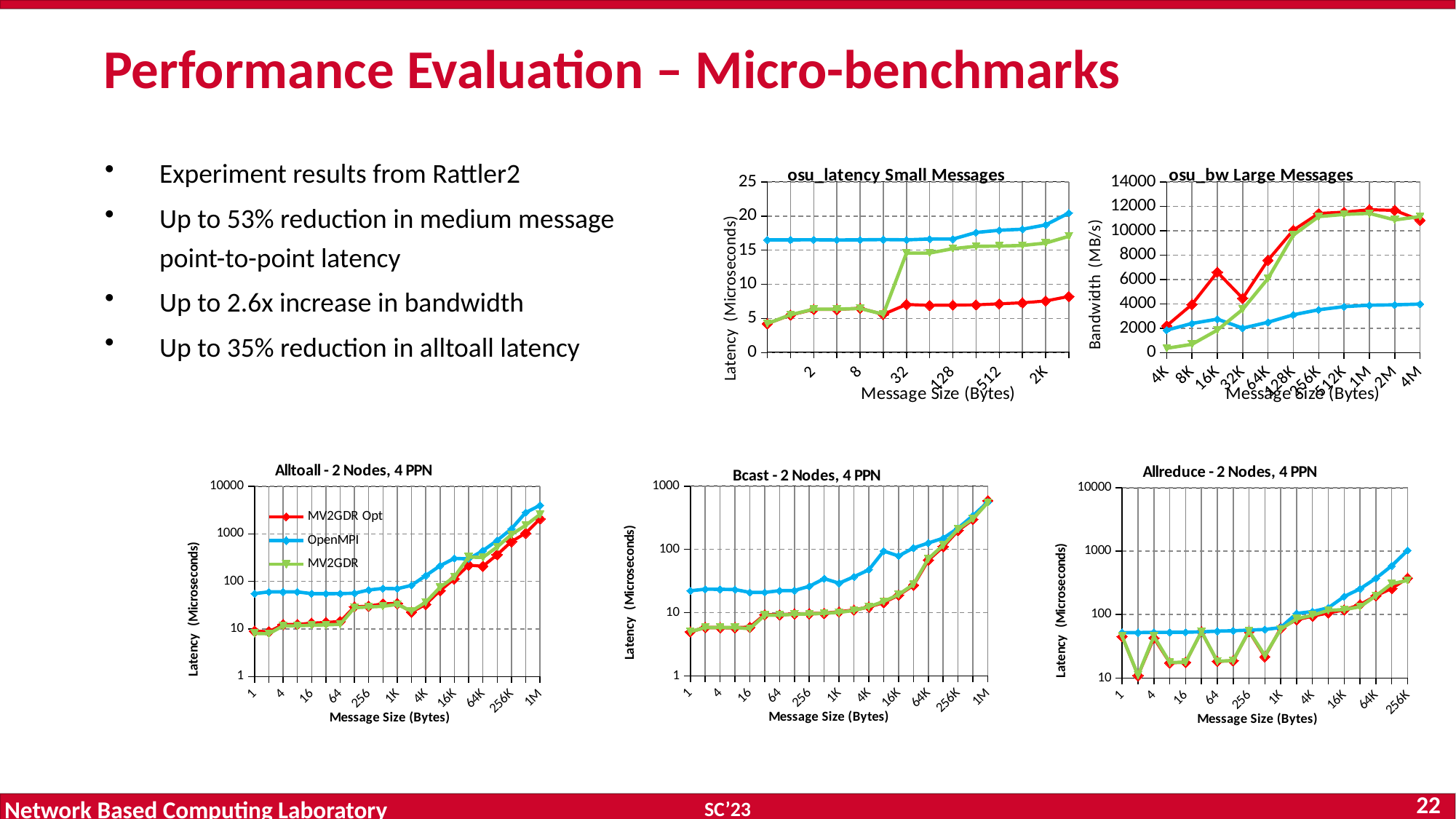
In the 'osu_bw Large Messages' chart, at message size 16K, which line has the higher value, the red line or the blue line? the red line How many message sizes are shown on the x axis of the 'osu_bw Large Messages' chart? 11 In the 'Bcast - 2 Nodes, 4 PPN' chart, at message size 16K, which line has the higher value, the blue line or the red line? the blue line In the 'Allreduce - 2 Nodes, 4 PPN' chart, is the blue line's value at message size 256K greater or less than 100? greater In the 'Bcast - 2 Nodes, 4 PPN' chart, does the blue line rise or fall from message size 64K to 1M? rise In the 'osu_latency Small Messages' chart, is the value of the blue line at message size 2 greater or less than 15? greater In the 'Alltoall - 2 Nodes, 4 PPN' chart, is the OpenMPI value at message size 1 greater or less than 10? greater In the 'Alltoall - 2 Nodes, 4 PPN' chart, what are the legend entries? MV2GDR Opt, OpenMPI, MV2GDR What kind of chart is the 'osu_latency Small Messages' chart? line chart What is the y-axis label of the 'osu_bw Large Messages' chart? Bandwidth (MB/s) In the 'Alltoall - 2 Nodes, 4 PPN' chart, how many series does the legend list? 3